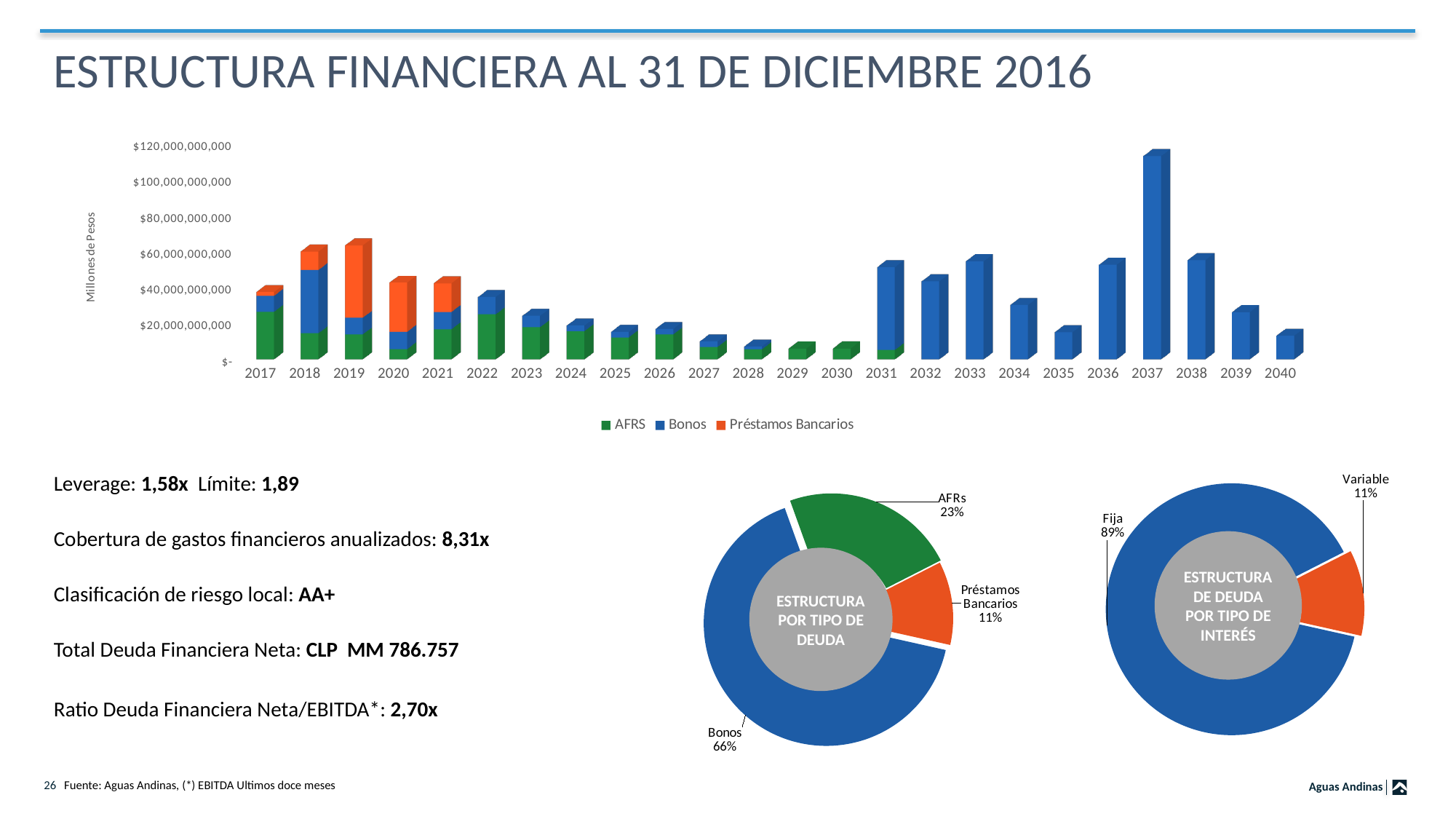
In the top bar chart, is the total value for 2031 greater or less than $40,000,000,000? greater In the 'ESTRUCTURA DE DEUDA POR TIPO DE INTERÉS' chart, what share is Fija? 89% In the top bar chart, do the total bar values rise or fall from 2019 to 2030? fall In the top bar chart, is the total value for 2040 greater or less than $20,000,000,000? less In the top bar chart, which year has the larger total bar, 2017 or 2018? 2018 In the top bar chart, how many years are shown on the x axis? 24 In the 'ESTRUCTURA POR TIPO DE DEUDA' chart, what is the difference between the AFRs share and the Préstamos Bancarios share? 12% In the top bar chart, how many series does the legend list? 3 In the top bar chart, which year has the highest total bar? 2037 In the 'ESTRUCTURA POR TIPO DE DEUDA' chart, what share is Bonos? 66% In the top bar chart, is the total value for 2037 greater or less than $100,000,000,000? greater What kind of chart is the large chart at the top of the slide showing years 2017 to 2040? bar chart